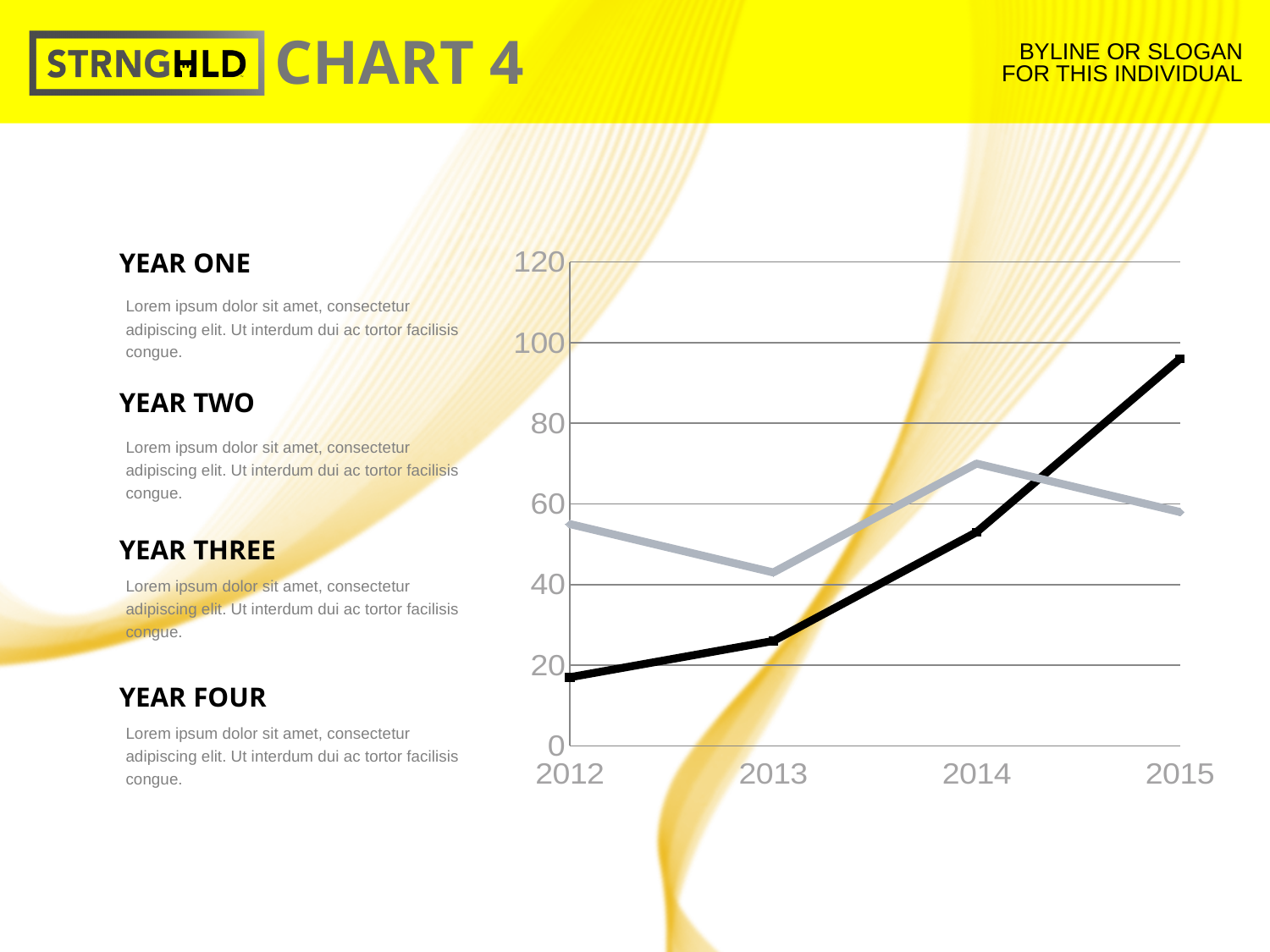
How many years are shown on the x axis of the chart? 4 In 2012, which line has the higher value, the black line or the gray line? the gray line Is the value of the black line in 2012 greater or less than 20? less Is the value of the black line in 2015 greater or less than 80? greater Does the black line rise or fall from 2012 to 2015? rises How many lines are plotted on the chart? 2 In which year does the black line reach its highest value? 2015 What kind of chart is shown on the slide? line chart What is the highest value shown on the y axis of the chart? 120 In which year does the gray line reach its lowest value? 2013 Is the value of the gray line in 2013 greater or less than 60? less